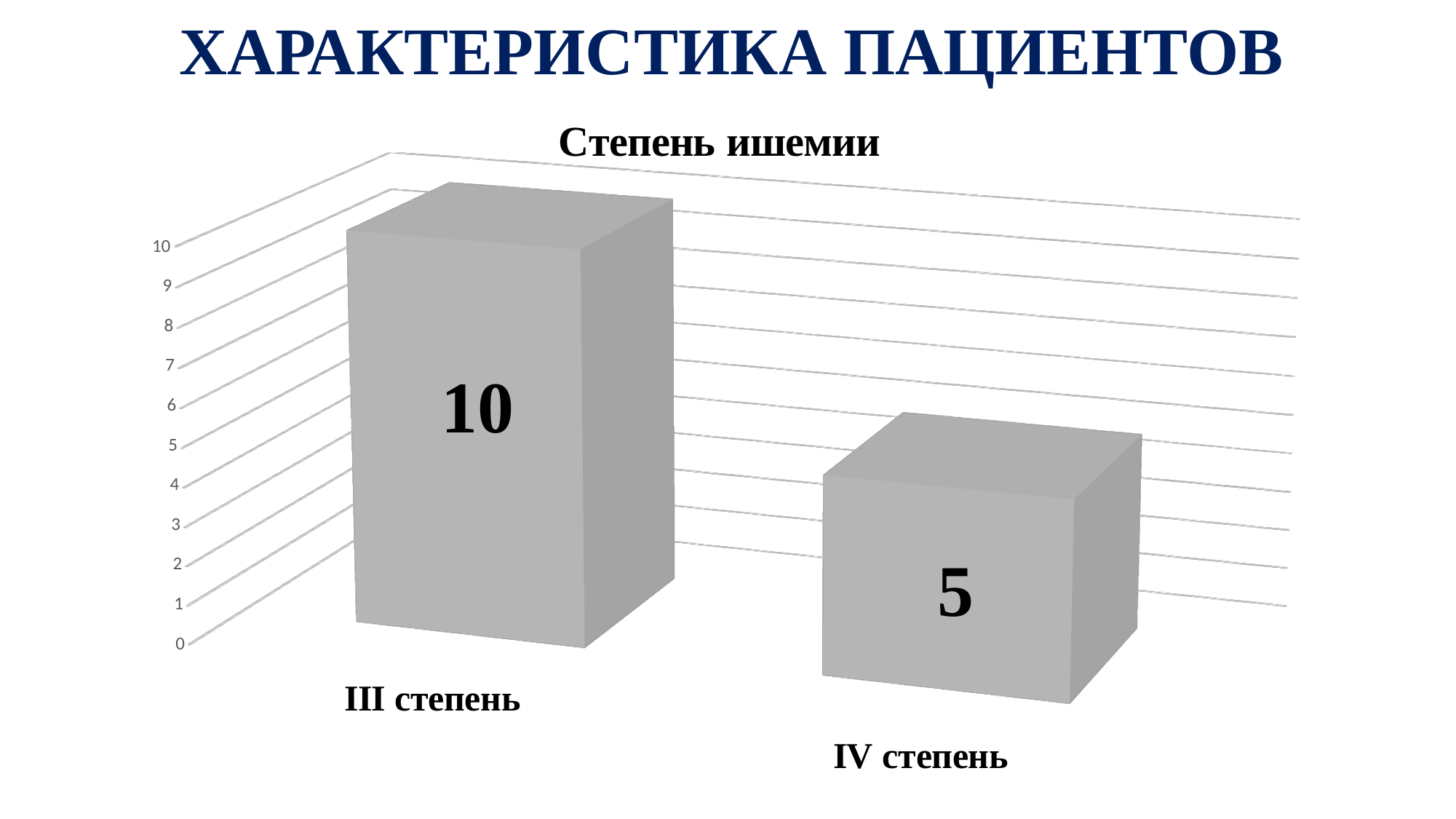
Which is larger, the value for III степень or the value for IV степень? III степень What is the maximum value shown on the vertical axis? 10 Is the value for IV степень greater or less than 8? less What kind of chart is shown on the slide? bar chart What is the value for III степень? 10 How many categories are shown in the chart? 2 What is the total of the two values shown in the chart? 15 What is the value for IV степень? 5 What is the difference between the values for III степень and IV степень? 5 What is the title of the chart? Степень ишемии Which category has the lowest value? IV степень Which category has the highest value? III степень